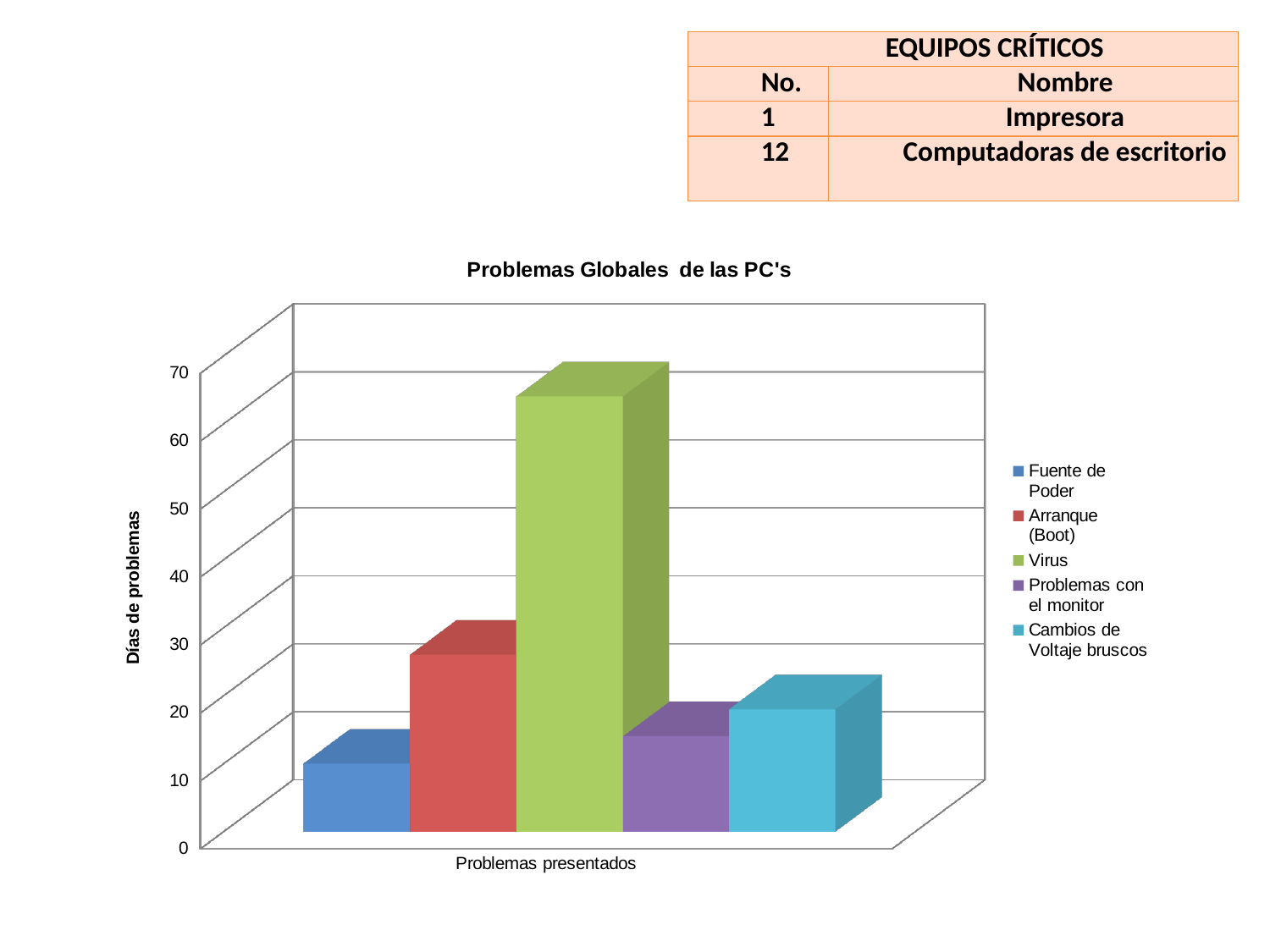
What is the title of the chart? Problemas Globales de las PC's What kind of chart is shown on the slide? bar chart Is the value for Problemas con el monitor greater or less than 30? less Which series has the lowest value in the chart? Fuente de Poder What is the label on the vertical axis of the chart? Días de problemas Is the value for Arranque (Boot) greater or less than 20? greater Is the value for Fuente de Poder greater or less than 20? less How many series does the chart legend list? 5 Which series has the highest value in the chart? Virus Which is larger, the value for Arranque (Boot) or the value for Cambios de Voltaje bruscos? Arranque (Boot) How many bars are plotted in the chart? 5